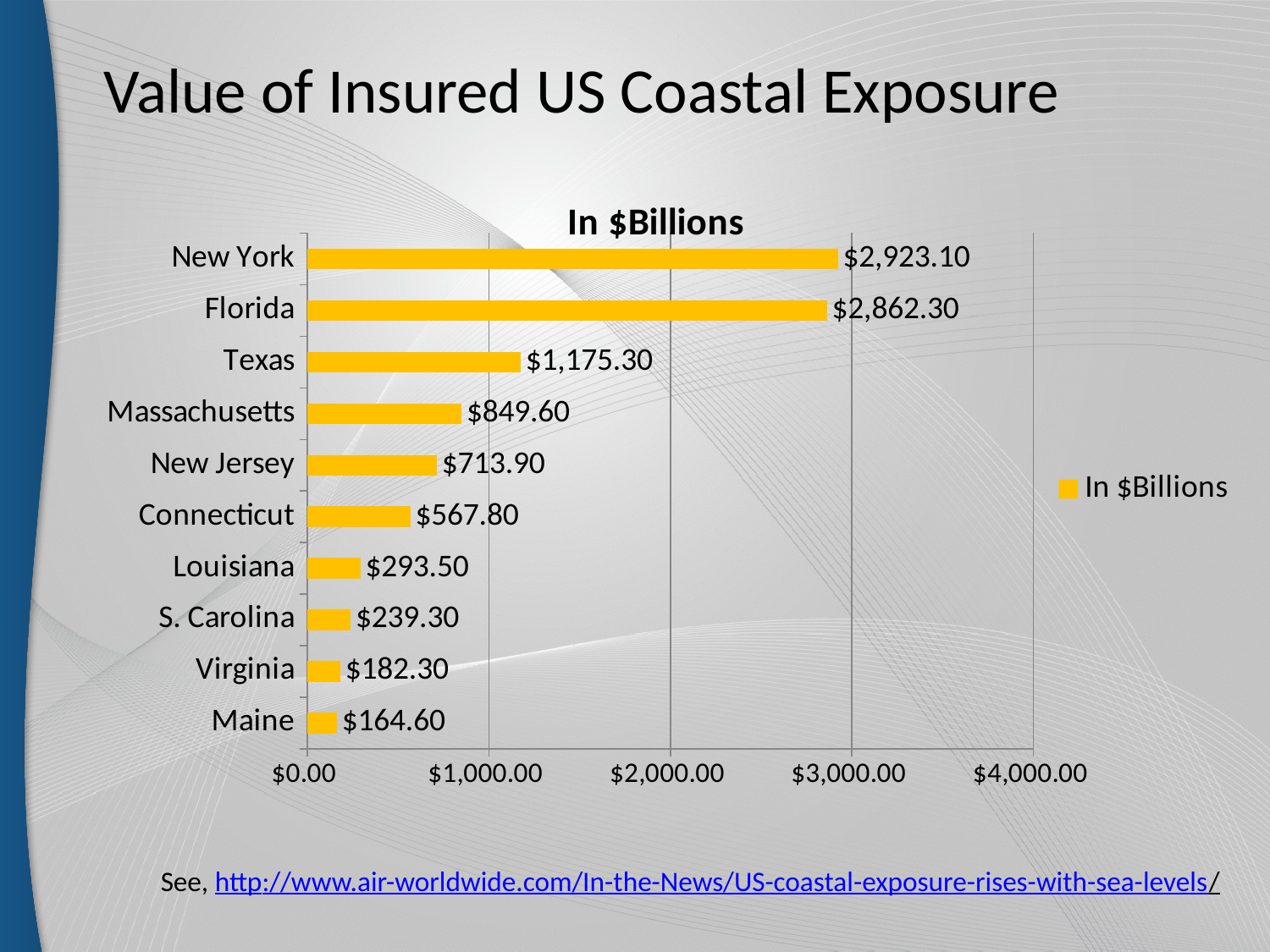
What is the difference between the values for Massachusetts and New Jersey? $135.70 What is the value for Maine? $164.60 Which state has the lowest value? Maine What is the difference between the values for New York and Florida? $60.80 Is the value for Texas greater or less than $1,000.00? greater What kind of chart is shown on the slide? bar chart Which is larger, the value for Louisiana or the value for S. Carolina? Louisiana What is the title of the chart? In $Billions How many states are shown in the chart? 10 Which state has the highest value? New York What is the value for Connecticut? $567.80 What is the value for Texas? $1,175.30